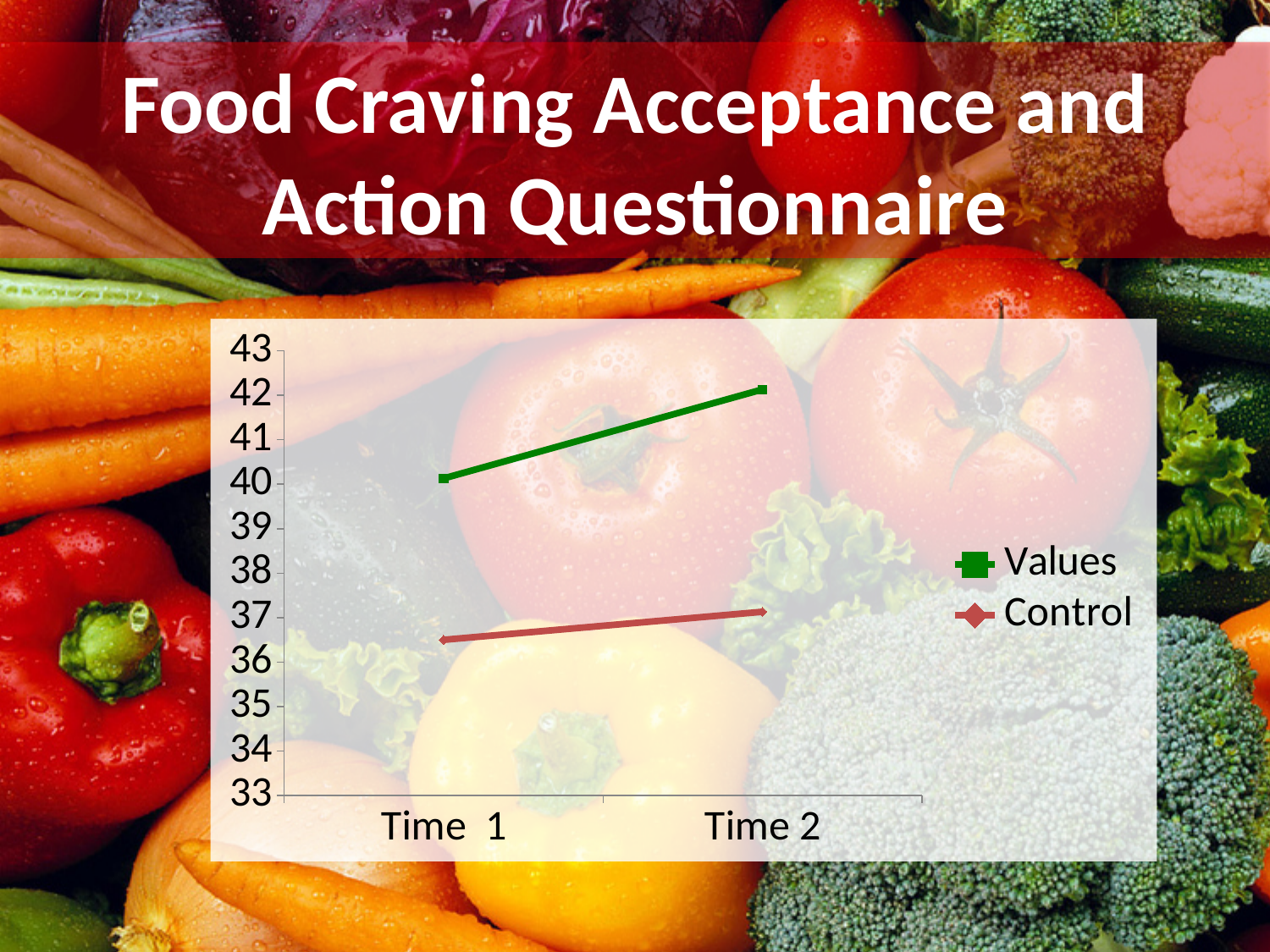
Is the value for Values at Time 2 greater or less than 41? greater Which series is higher at Time 2, Values or Control? Values What kind of chart is shown on the slide? line chart Is the value for Control at Time 1 greater or less than 37? less Does the Values line rise or fall from Time 1 to Time 2? rise How many time points are shown on the x axis? 2 What colour is the line for the Values series? green Is the value for Control at Time 2 greater or less than 38? less How many series does the legend list? 2 Which series is higher at Time 1, Values or Control? Values Does the Control line rise or fall from Time 1 to Time 2? rise